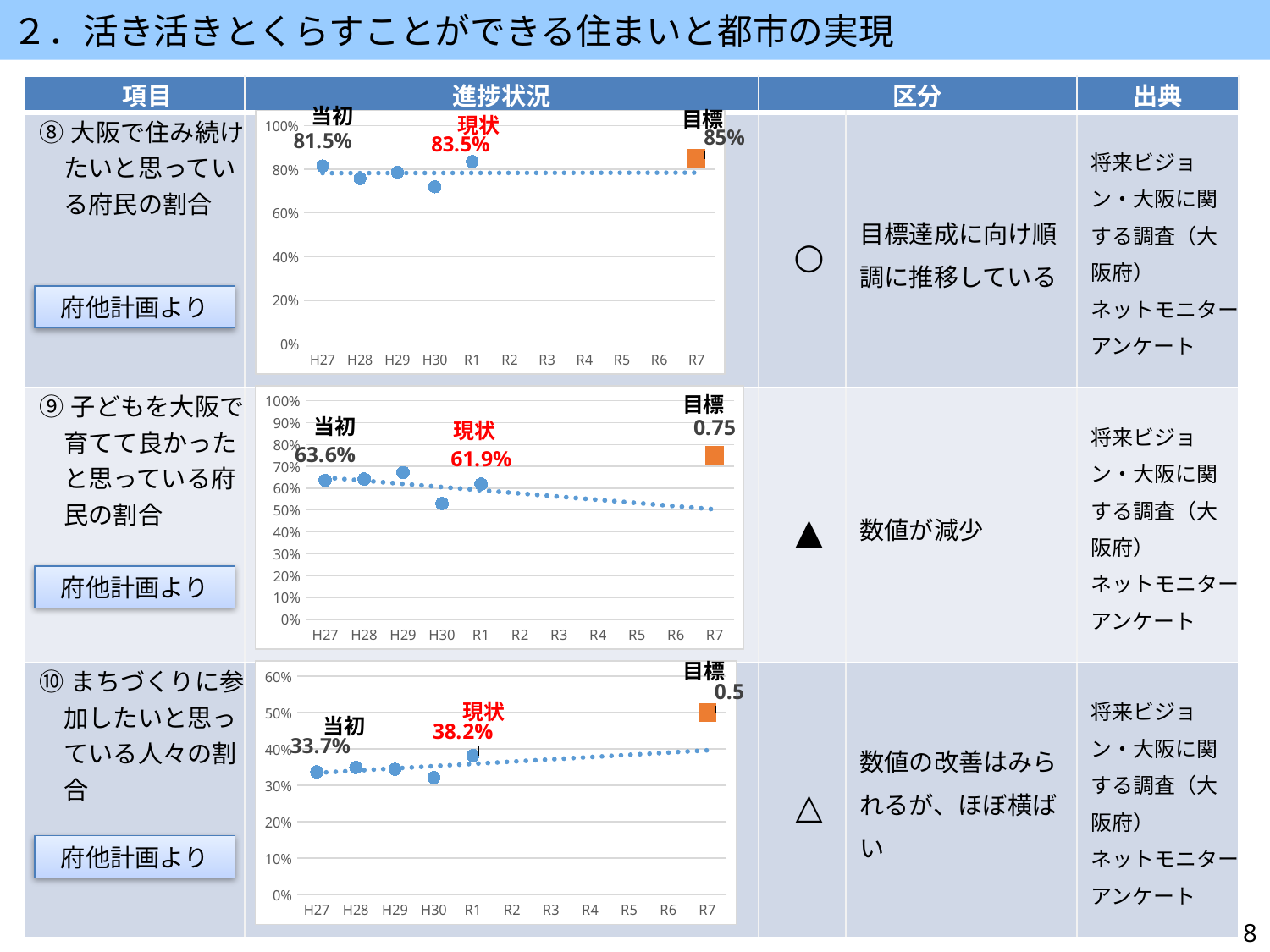
In the top chart (⑧ 大阪で住み続けたいと思っている府民の割合), what is the 当初 (initial) value? 81.5% In the top chart (⑧ 大阪で住み続けたいと思っている府民の割合), what is the 現状 (current) value? 83.5% In the middle chart (⑨ 子どもを大阪で育てて良かったと思っている府民の割合), what is the 当初 (initial) value? 63.6% In the bottom chart (⑩ まちづくりに参加したいと思っている人々の割合), what is the difference between the 現状 value (38.2%) and the 当初 value (33.7%)? 4.5% How many labels are shown on the x axis of the bottom chart (⑩ まちづくりに参加したいと思っている人々の割合)? 11 In the middle chart (⑨ 子どもを大阪で育てて良かったと思っている府民の割合), does the dotted trend line rise or fall from H27 to R7? fall In the top chart (⑧ 大阪で住み続けたいと思っている府民の割合), by how many percentage points does the 現状 value exceed the 当初 value? 2% In the top chart (⑧ 大阪で住み続けたいと思っている府民の割合), is the value for H30 greater or less than 80%? less In the middle chart (⑨ 子どもを大阪で育てて良かったと思っている府民の割合), what is the 目標 (target) value shown? 0.75 In the bottom chart (⑩ まちづくりに参加したいと思っている人々の割合), what is the 現状 (current) value? 38.2% In the top chart (⑧ 大阪で住み続けたいと思っている府民の割合), what is the 目標 (target) value? 85% In the middle chart (⑨ 子どもを大阪で育てて良かったと思っている府民の割合), which is larger, the 当初 value or the 現状 value? 当初 (63.6%)